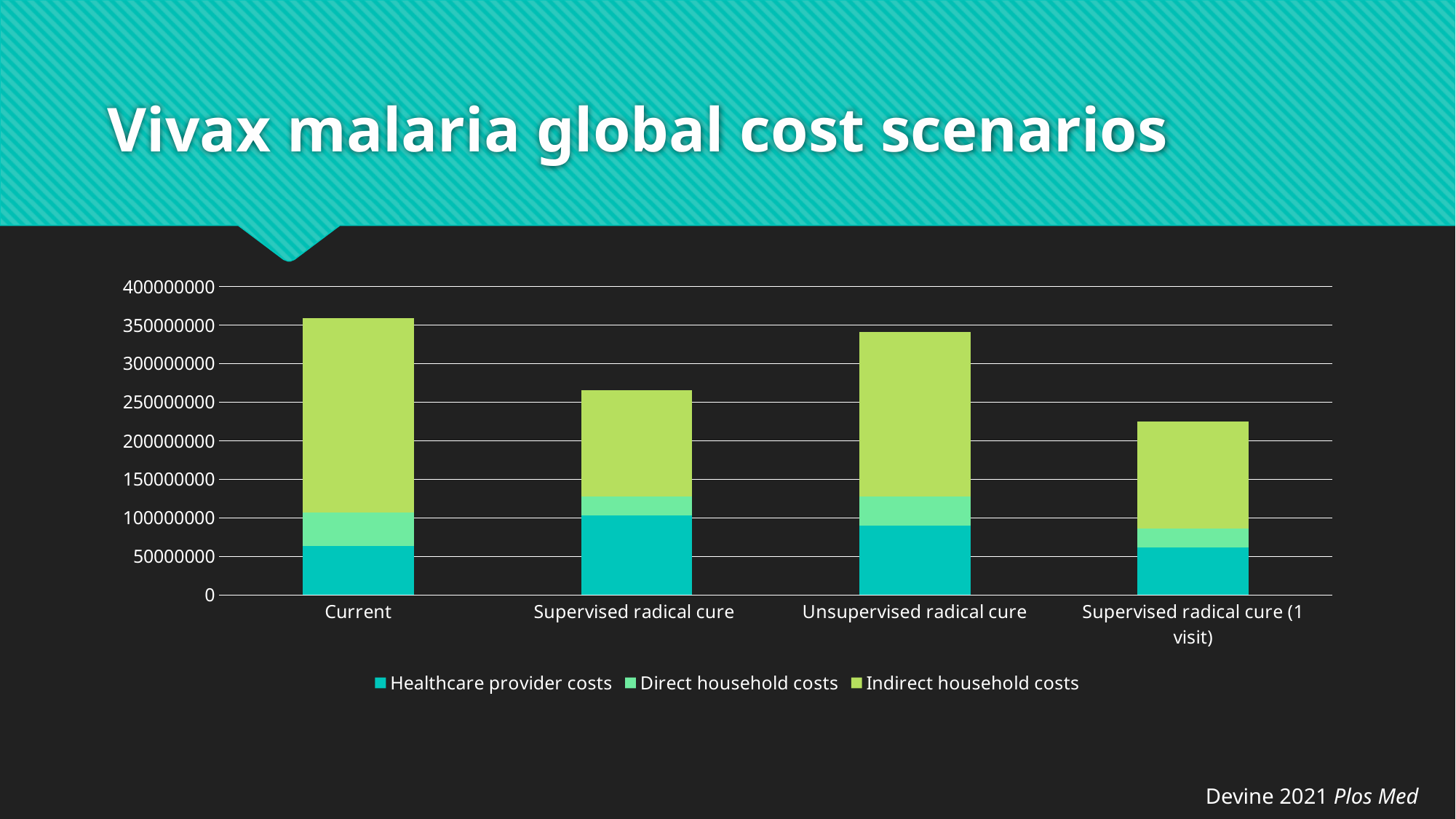
Which series is shown in the lightest green colour at the top of each bar? Indirect household costs Which scenario has the lowest total cost? Supervised radical cure (1 visit) Which scenario has the largest Healthcare provider costs segment? Supervised radical cure Is the total cost for Supervised radical cure greater or less than 300000000? less Is the total cost for Unsupervised radical cure greater or less than 300000000? greater How many series does the legend list? 3 What is the title of the slide containing the chart? Vivax malaria global cost scenarios Which scenario has the highest total cost? Current What kind of chart is shown on the slide? Stacked bar chart Which has a larger total cost, Unsupervised radical cure or Supervised radical cure (1 visit)? Unsupervised radical cure How many cost scenarios (categories) are shown on the x axis? 4 Which has a larger total cost, Current or Supervised radical cure? Current